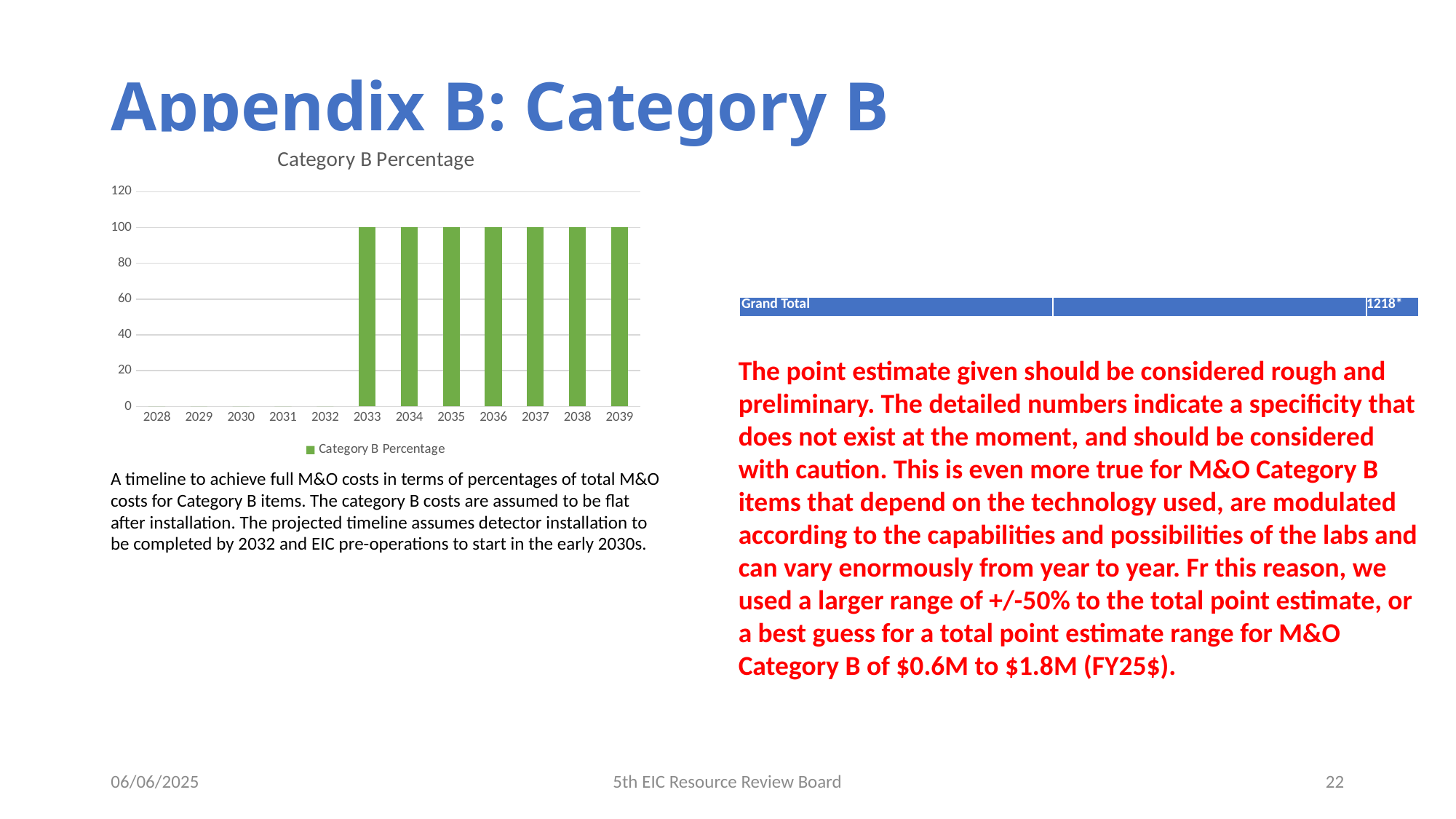
Is the value for 2037 greater or less than 80? greater What is the difference between the value for 2039 and the value for 2028? 100 How many years are shown on the x axis of the chart? 12 How many series does the chart legend list? 1 What is the Category B Percentage value for 2030? 0 What kind of chart is shown on the slide? bar chart Which is larger, the value for 2032 or the value for 2033? 2033 What is the title of the chart? Category B Percentage Do the values rise or fall along the x axis from 2028 to 2039? rise What is the Category B Percentage value for 2035? 100 What is the highest value shown on the y axis of the chart? 120 What is the first year in which the Category B Percentage reaches 100? 2033